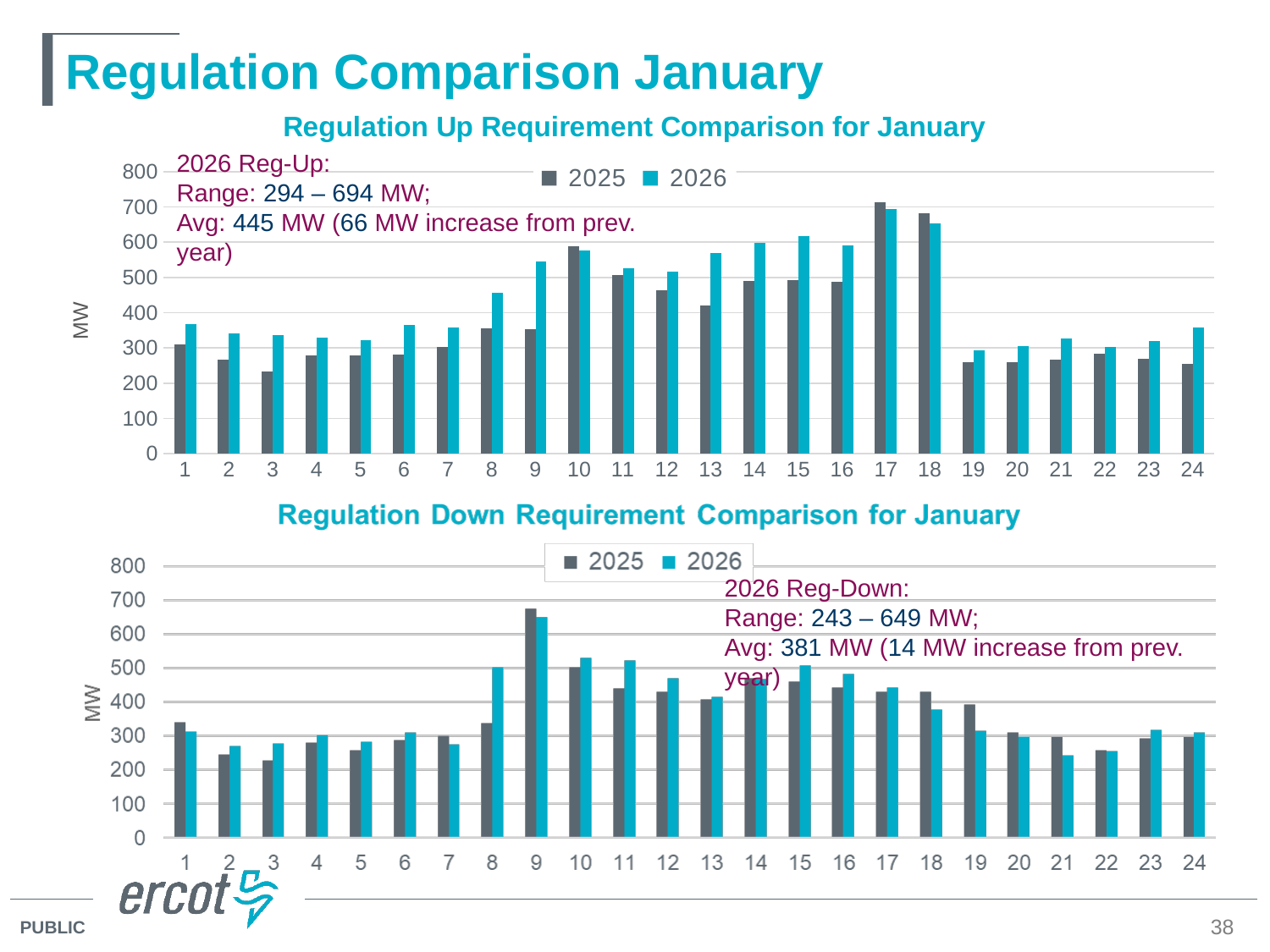
According to the annotation on the 'Regulation Up Requirement Comparison for January' chart, what is the 2026 Reg-Up average? 445 MW According to the annotation on the 'Regulation Down Requirement Comparison for January' chart, what is the 2026 Reg-Down range? 243 – 649 MW In the 'Regulation Up Requirement Comparison for January' chart, is the 2025 value at hour 1 greater or less than 400? less In the 'Regulation Up Requirement Comparison for January' chart, at which hour is the 2025 value highest? 17 In the 'Regulation Down Requirement Comparison for January' chart, how many hour categories are shown on the x axis? 24 In the 'Regulation Up Requirement Comparison for January' chart, is the 2026 value at hour 9 greater or less than 500? greater In the 'Regulation Up Requirement Comparison for January' chart, how many series does the legend list? 2 In the 'Regulation Down Requirement Comparison for January' chart, at which hour is the 2026 value highest? 9 In the 'Regulation Up Requirement Comparison for January' chart, at hour 8, which series has the larger value, 2025 or 2026? 2026 In the 'Regulation Down Requirement Comparison for January' chart, at hour 18, which series has the larger value, 2025 or 2026? 2025 What kind of chart is the 'Regulation Up Requirement Comparison for January' chart? bar chart In the 'Regulation Down Requirement Comparison for January' chart, is the 2025 value at hour 9 greater or less than 600? greater